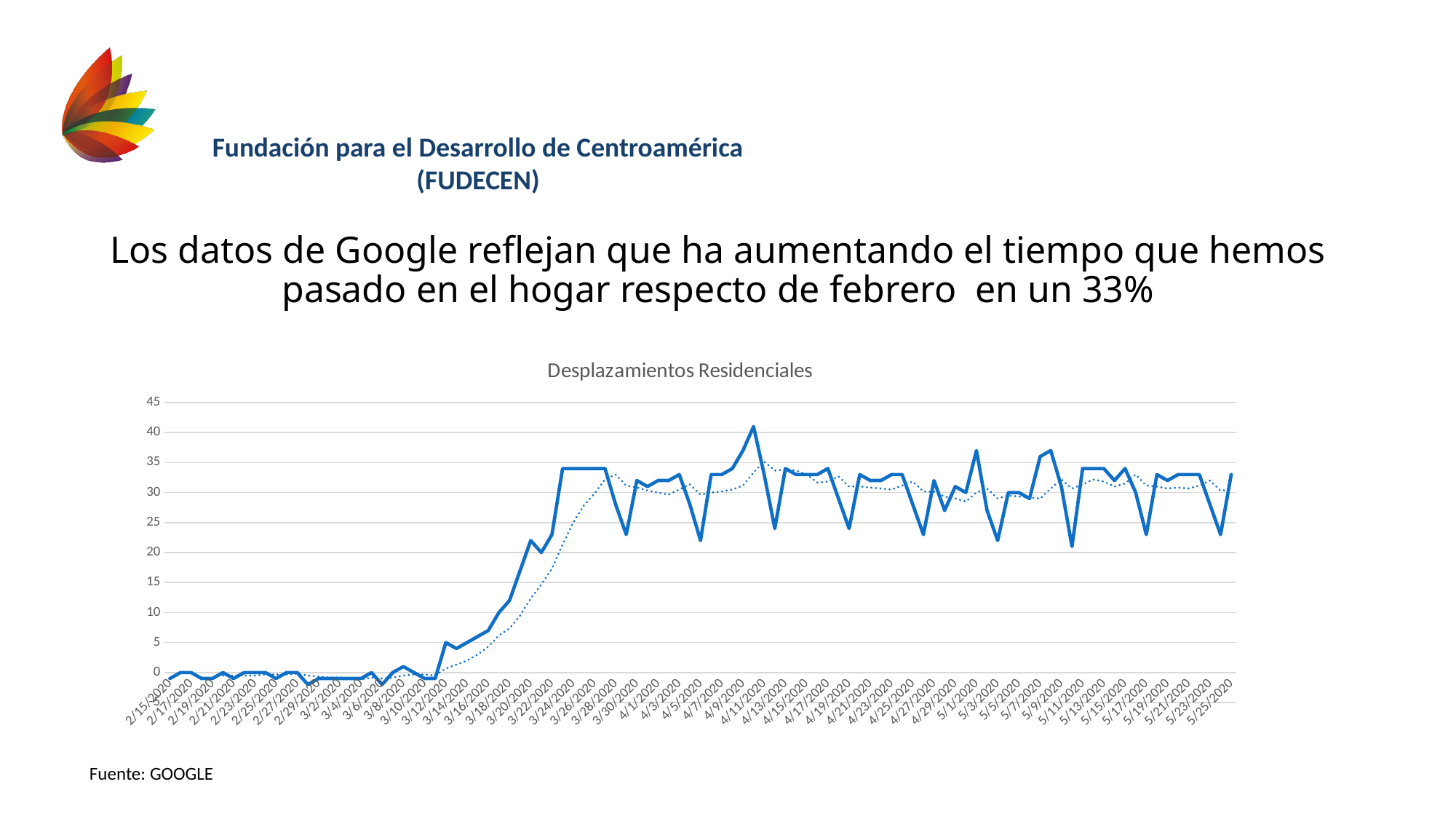
Is the value of the solid line on 4/9/2020 larger or smaller than its value on 3/2/2020? larger What source is cited for the chart data? GOOGLE Is the value of the solid line on 3/6/2020 greater or less than 10? less On which date does the solid line reach its highest value? 4/10/2020 Is the value of the solid line on 4/9/2020 greater or less than 35? greater What kind of chart is shown on the slide? line chart Is the value of the solid line on 3/24/2020 greater or less than 30? greater What is the title of the chart? Desplazamientos Residenciales Does the solid line rise or fall between 3/10/2020 and 3/24/2020? rise